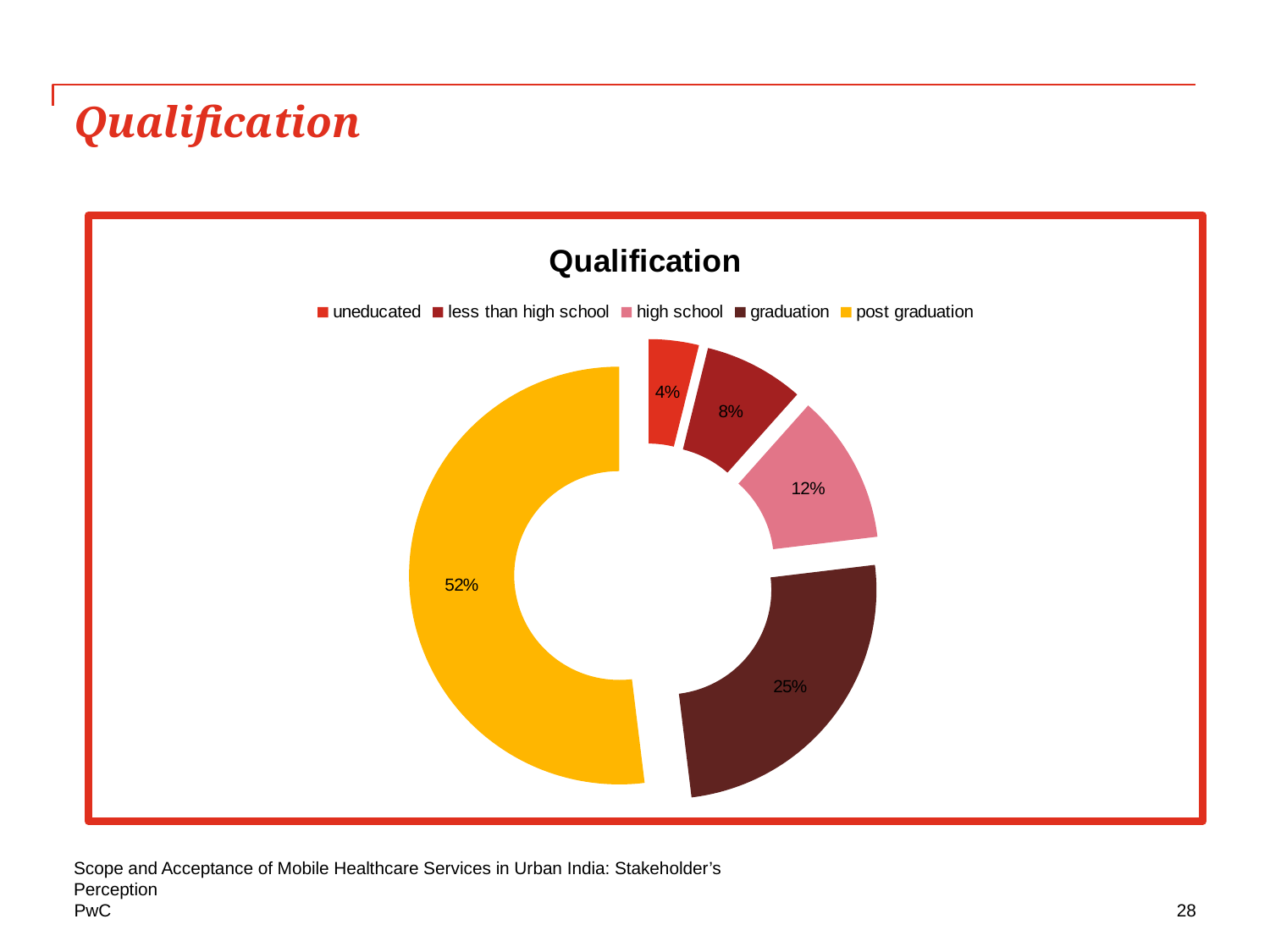
Which qualification category has the smallest share? uneducated What percentage is shown for uneducated? 4% What colour represents post graduation in the chart? yellow Which qualification category has the largest share? post graduation What is the title of the chart? Qualification What percentage is shown for graduation? 25% What is the difference in percentage points between post graduation and graduation? 27 How many categories does the Qualification chart show? 5 What percentage is shown for high school? 12% What kind of chart is shown on the slide? doughnut chart Which is larger, the share for less than high school or the share for high school? high school What share of the Qualification chart is post graduation? 52%